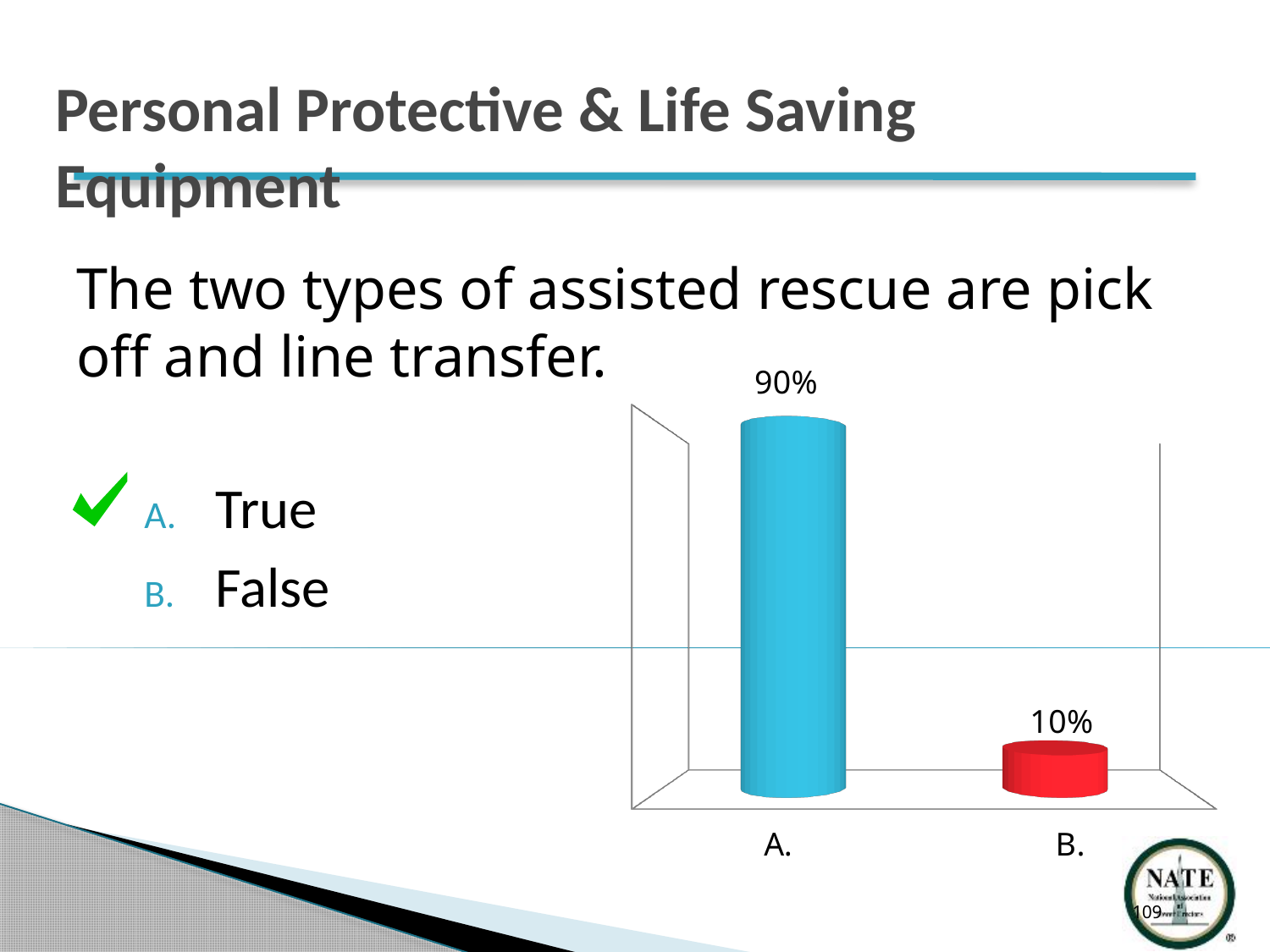
What is the total of the values for A. and B. in the chart? 100% Which category has the larger value, A. or B.? A. What colour is the bar for category B. in the chart? Red What colour is the bar for category A. in the chart? Blue How many categories are plotted in the chart? 2 What is the value shown for category B. in the chart? 10% What kind of chart is shown on the slide? Bar chart Which category has the lowest value in the chart? B. Which category has the highest value in the chart? A. What is the difference between the values for A. and B. in the chart? 80% What is the value shown for category A. in the chart? 90%